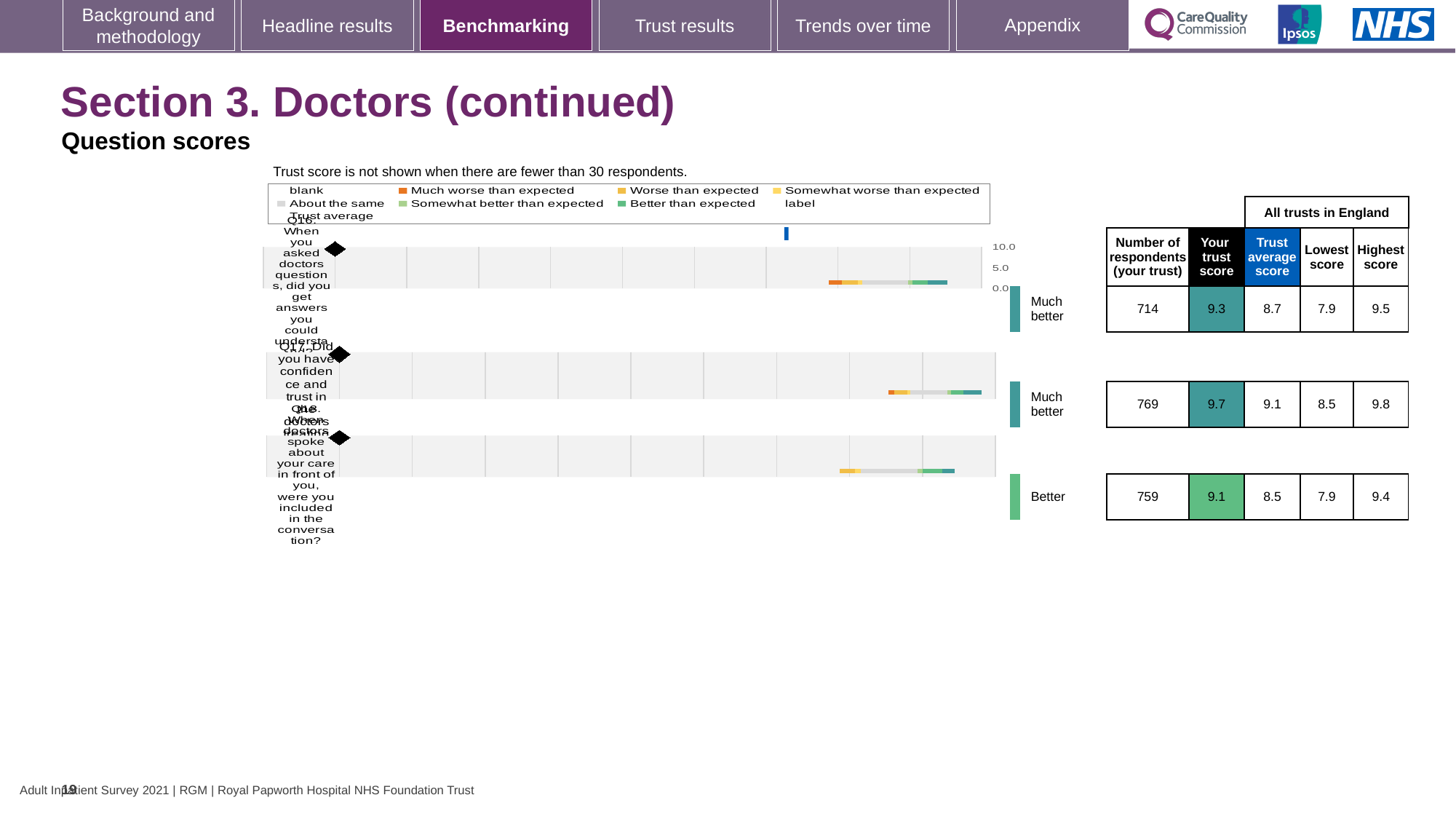
What is the 'Lowest score' across all trusts in England for Q17? 8.5 What benchmark label is shown next to Q18 in the chart? Better What is the difference between the 'Your trust score' and the 'Trust average score' for Q17? 0.6 What kind of chart is used to show the question scores on this slide? bar chart Which question has the highest 'Your trust score'? Q17 For Q16, which is larger: the 'Your trust score' or the 'Trust average score'? Your trust score What is the 'Highest score' across all trusts in England for Q18? 9.4 What is the 'Your trust score' value for Q17? 9.7 Which question has the lowest 'Your trust score'? Q18 How many questions (categories) are plotted in the question scores chart? 3 What is the highest tick value shown on the chart's score axis? 10.0 How many respondents (your trust) are shown for Q16? 714